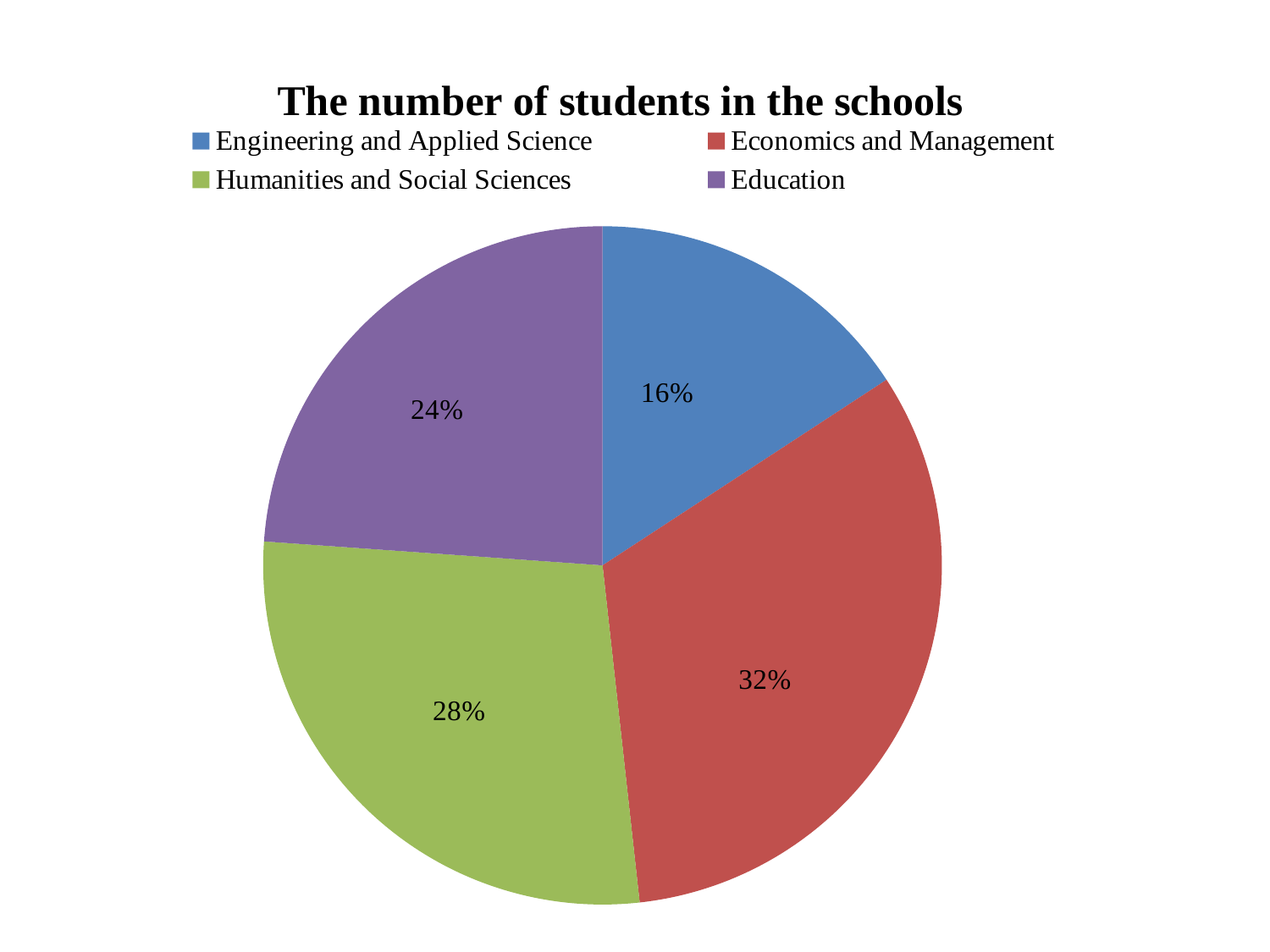
What share of the pie does Education have? 24% Which has a larger share, Humanities and Social Sciences or Education? Humanities and Social Sciences What share of the pie does Humanities and Social Sciences have? 28% Which school has the smallest share of students? Engineering and Applied Science What share of the pie does Engineering and Applied Science have? 16% How many slices does the pie chart have? 4 Which school has the largest share of students? Economics and Management What is the difference in percentage points between Humanities and Social Sciences and Education? 4 What kind of chart is shown on the slide? Pie chart What is the difference in percentage points between Economics and Management and Engineering and Applied Science? 16 What is the title of the chart? The number of students in the schools